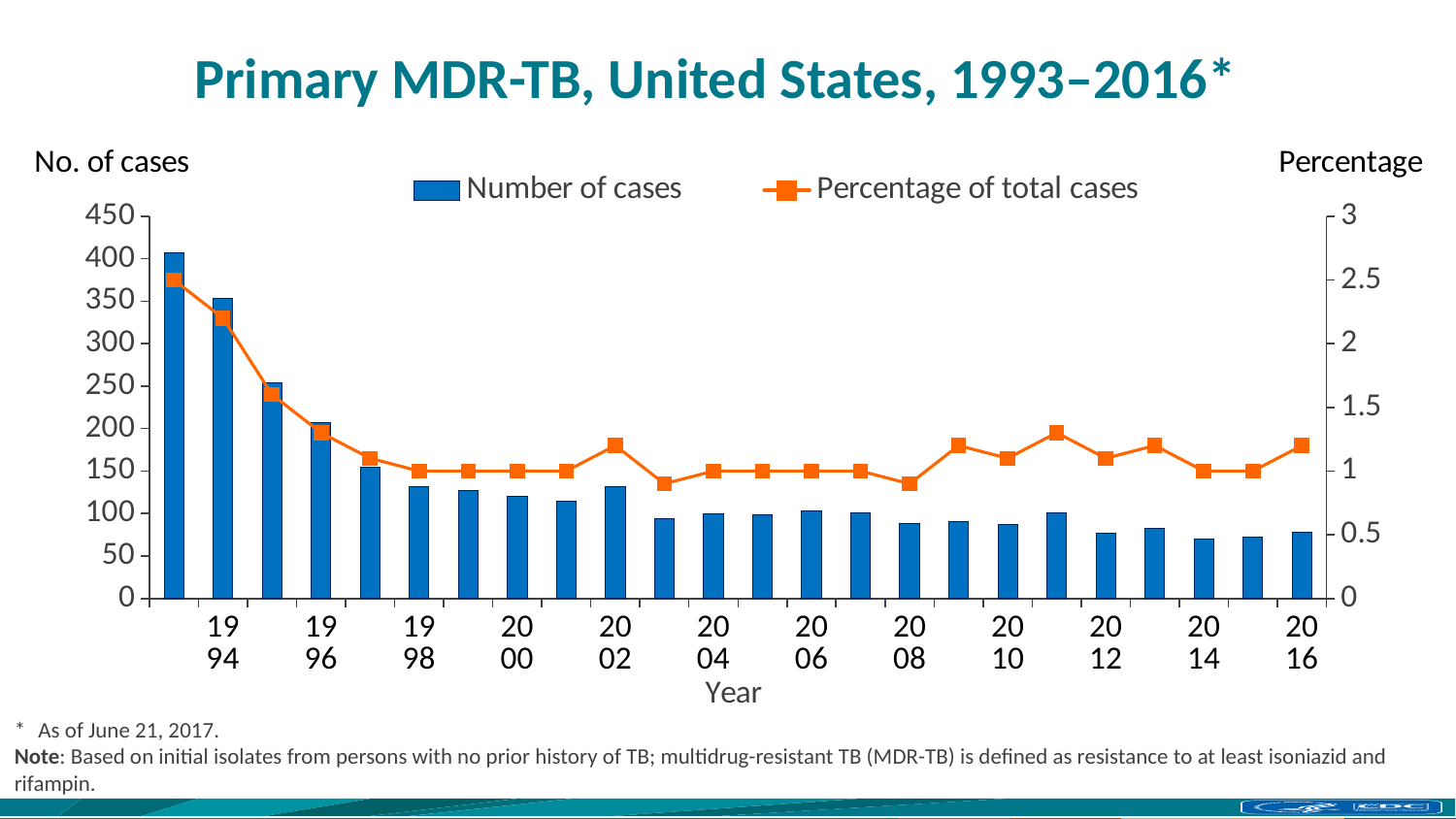
Overall, does the number of cases rise or fall from the early 1990s to 2016? fall What kind of chart is shown on the slide? A combined bar and line chart How many series does the legend list? 2 Is the number of cases for 1996 greater or less than 250? less Is the number of cases for 1994 greater or less than 300? greater Is the percentage of total cases for 1996 greater or less than 1.5? less Which year has the larger number of cases, 2002 or 2004? 2002 What is the label of the right-hand vertical axis? Percentage How many years (bars) are plotted in the chart? 24